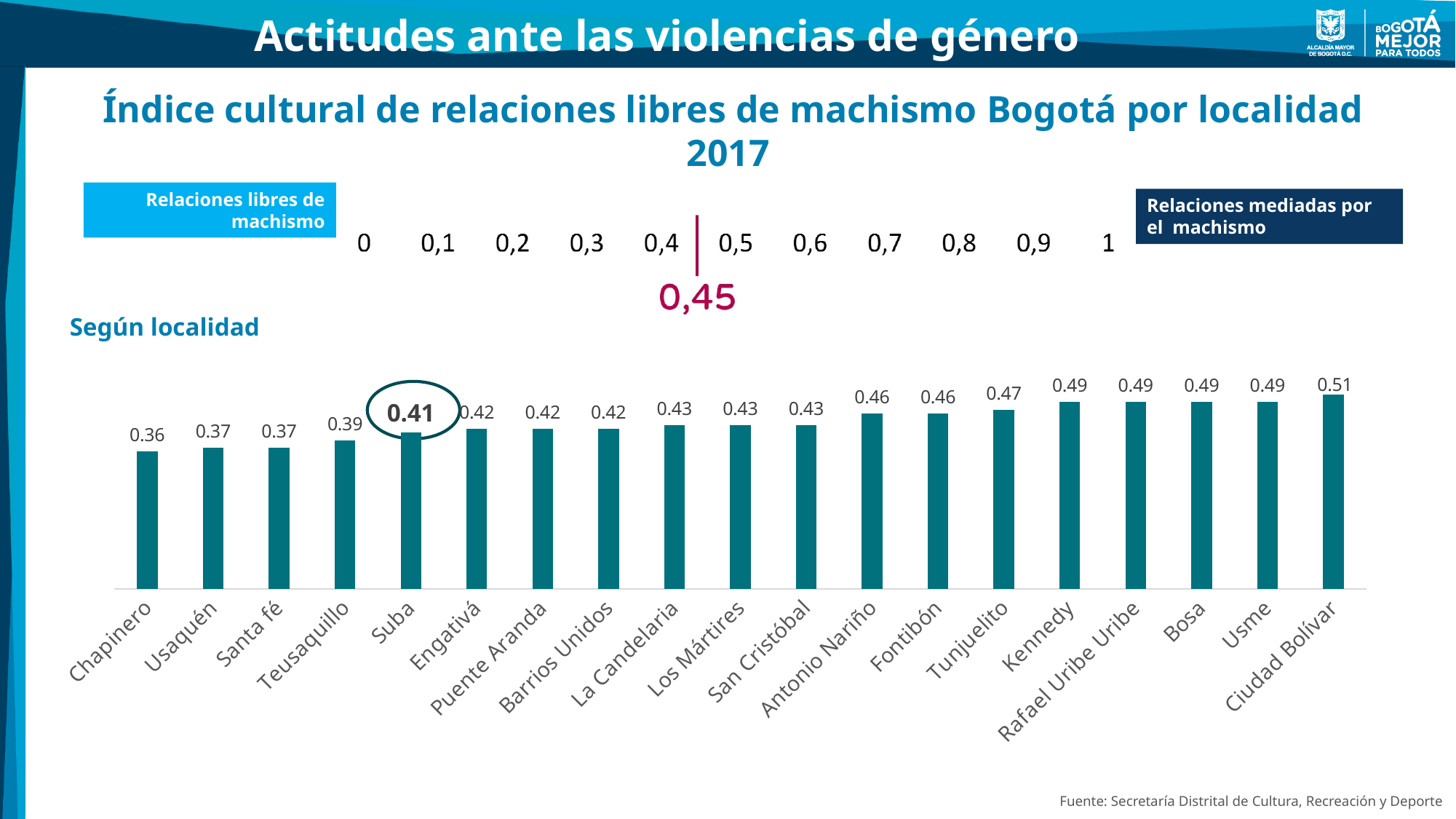
What is the difference between the values for Ciudad Bolívar and Chapinero? 0.15 Which locality has the highest value in the bar chart? Ciudad Bolívar What overall index value is marked on the scale above the bar chart? 0,45 Which locality has the lowest value in the bar chart? Chapinero How many localities are shown in the bar chart? 19 What is the value for Tunjuelito in the bar chart? 0.47 What kind of chart is shown on the slide? Bar chart Which is larger, the value for Fontibón or the value for Engativá? Fontibón What is the value for Chapinero in the bar chart? 0.36 What is the value for Suba in the bar chart? 0.41 What is the value for Antonio Nariño in the bar chart? 0.46 What is the difference between the values for Kennedy and Teusaquillo? 0.10